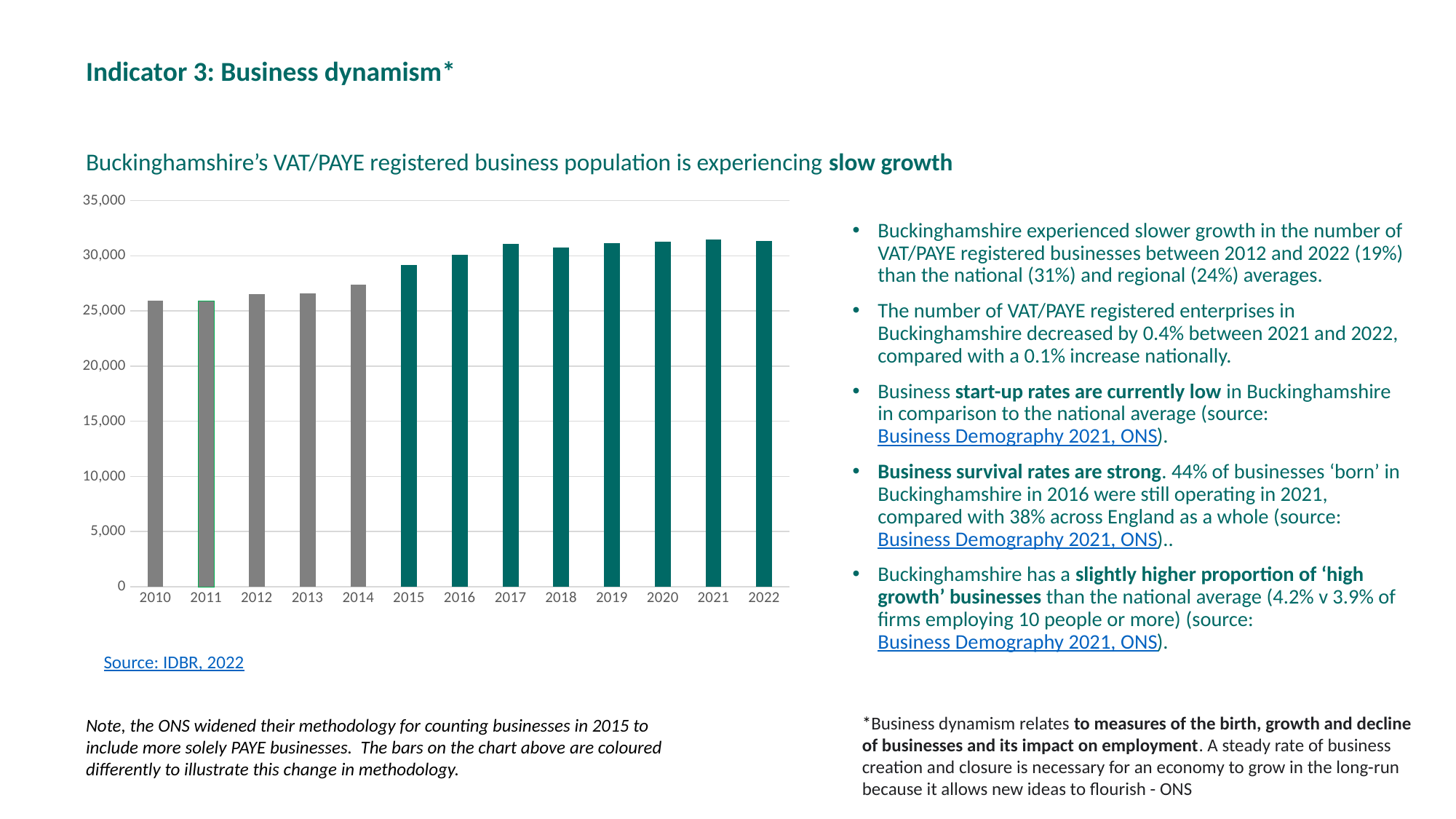
Is the value for 2017 greater or less than 30,000? greater What kind of chart is shown on the slide? bar chart Which year has the larger value, 2010 or 2015? 2015 Is the value for 2015 greater or less than 30,000? less Is the value for 2014 greater or less than 25,000? greater Do the values generally rise or fall from 2010 to 2022? rise Which year has the larger value, 2014 or 2017? 2017 How many years are plotted on the chart? 13 Which year is the first one shown on the x axis of the chart? 2010 From which year onward are the bars coloured teal rather than grey? 2015